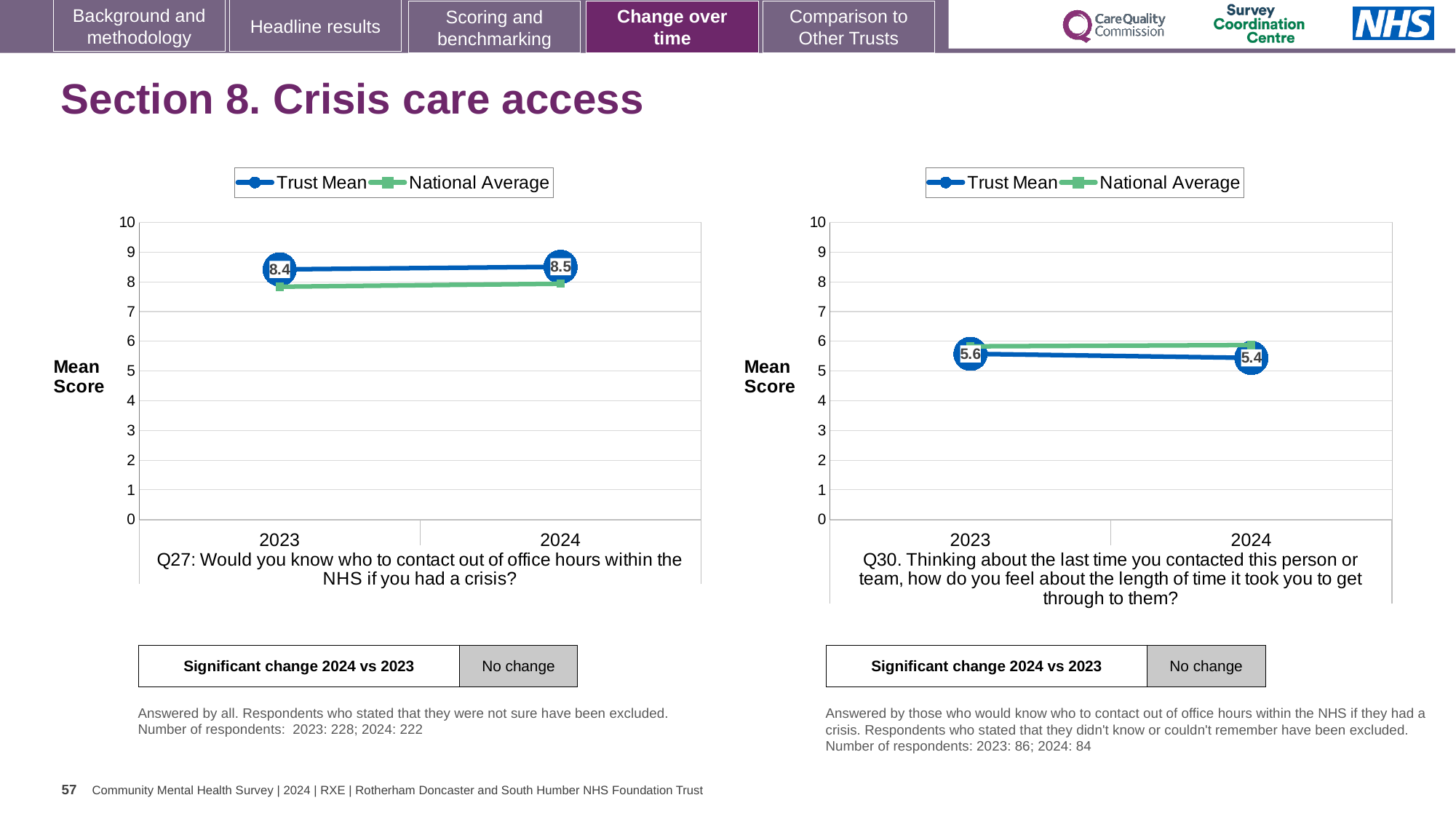
In the right chart (Q30), is the National Average for 2024 greater or less than 7? less What kind of chart is the right chart (Q30)? line chart In the left chart (Q27), does the Trust Mean rise or fall from 2023 to 2024? rise In the left chart (Q27), what is the Trust Mean for 2024? 8.5 In the right chart (Q30), what is the difference between the Trust Mean for 2023 and 2024? 0.2 In the right chart (Q30), what is the Trust Mean for 2023? 5.6 In the right chart (Q30), what is the Trust Mean for 2024? 5.4 How many years are shown on the x axis of the left chart (Q27)? 2 In the left chart (Q27), is the National Average for 2023 greater or less than 9? less In the right chart (Q30), does the Trust Mean rise or fall from 2023 to 2024? fall In the left chart (Q27), what is the Trust Mean for 2023? 8.4 How many series does the legend of the left chart (Q27) list? 2